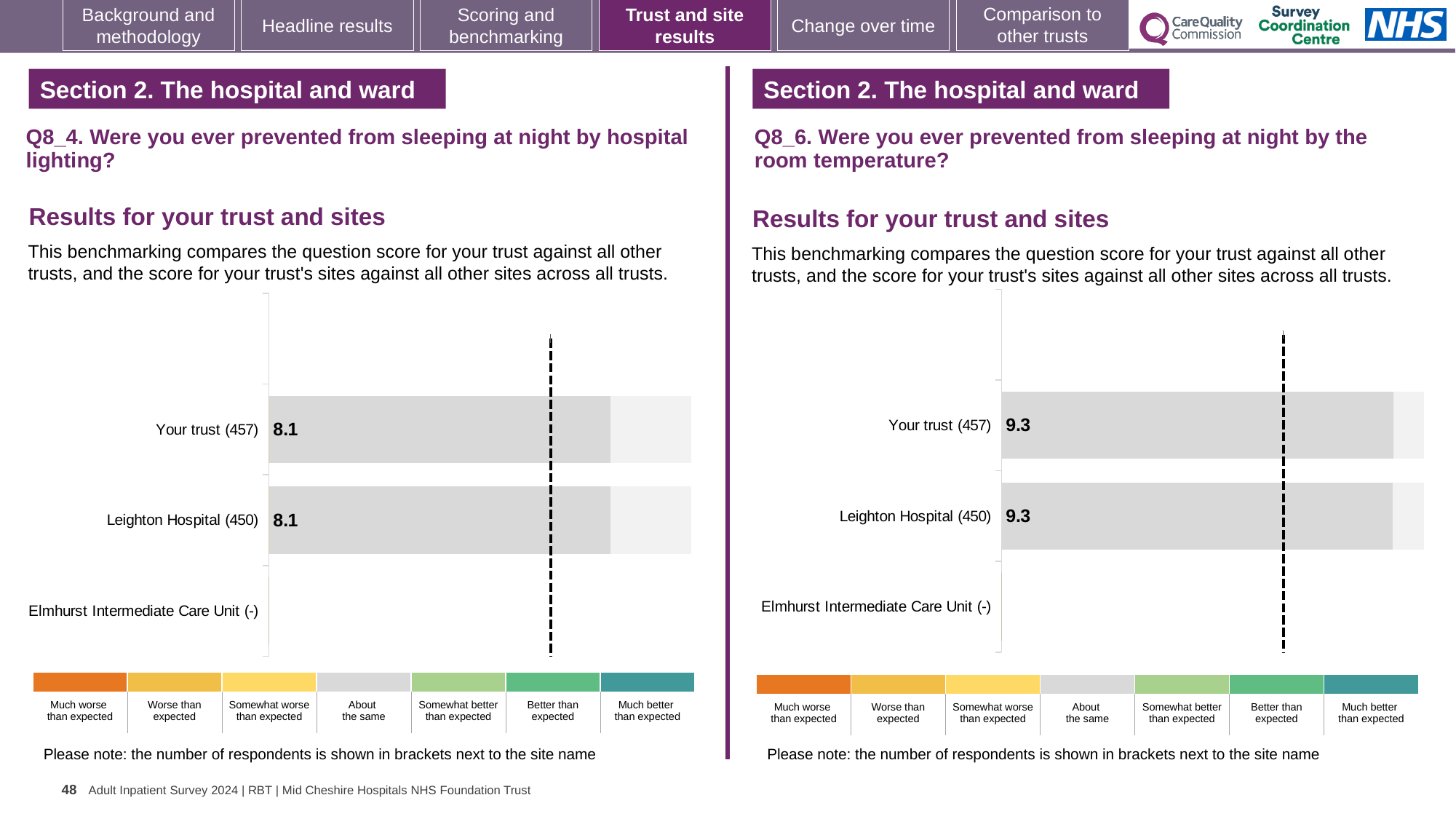
How many categories are listed on the y axis of the right chart (Q8_6, room temperature)? 3 On the right chart (Q8_6, room temperature), what is the difference between the scores for Your trust and Leighton Hospital? 0 On the left chart (Q8_4, hospital lighting), what is the difference between the scores for Your trust and Leighton Hospital? 0 On the left chart (Q8_4, hospital lighting), what is the score for Your trust (457)? 8.1 On the left chart (Q8_4, hospital lighting), what is the score for Leighton Hospital (450)? 8.1 How many benchmark categories does the colour key below the left chart (Q8_4, hospital lighting) list? 7 What kind of chart is shown on the left (Q8_4, hospital lighting)? Bar chart On the left chart (Q8_4, hospital lighting), how many respondents are shown in brackets for Leighton Hospital? 450 On the right chart (Q8_6, room temperature), what is the score for Your trust (457)? 9.3 On the right chart (Q8_6, room temperature), which category has no bar plotted? Elmhurst Intermediate Care Unit (-) On the right chart (Q8_6, room temperature), what is the score for Leighton Hospital (450)? 9.3